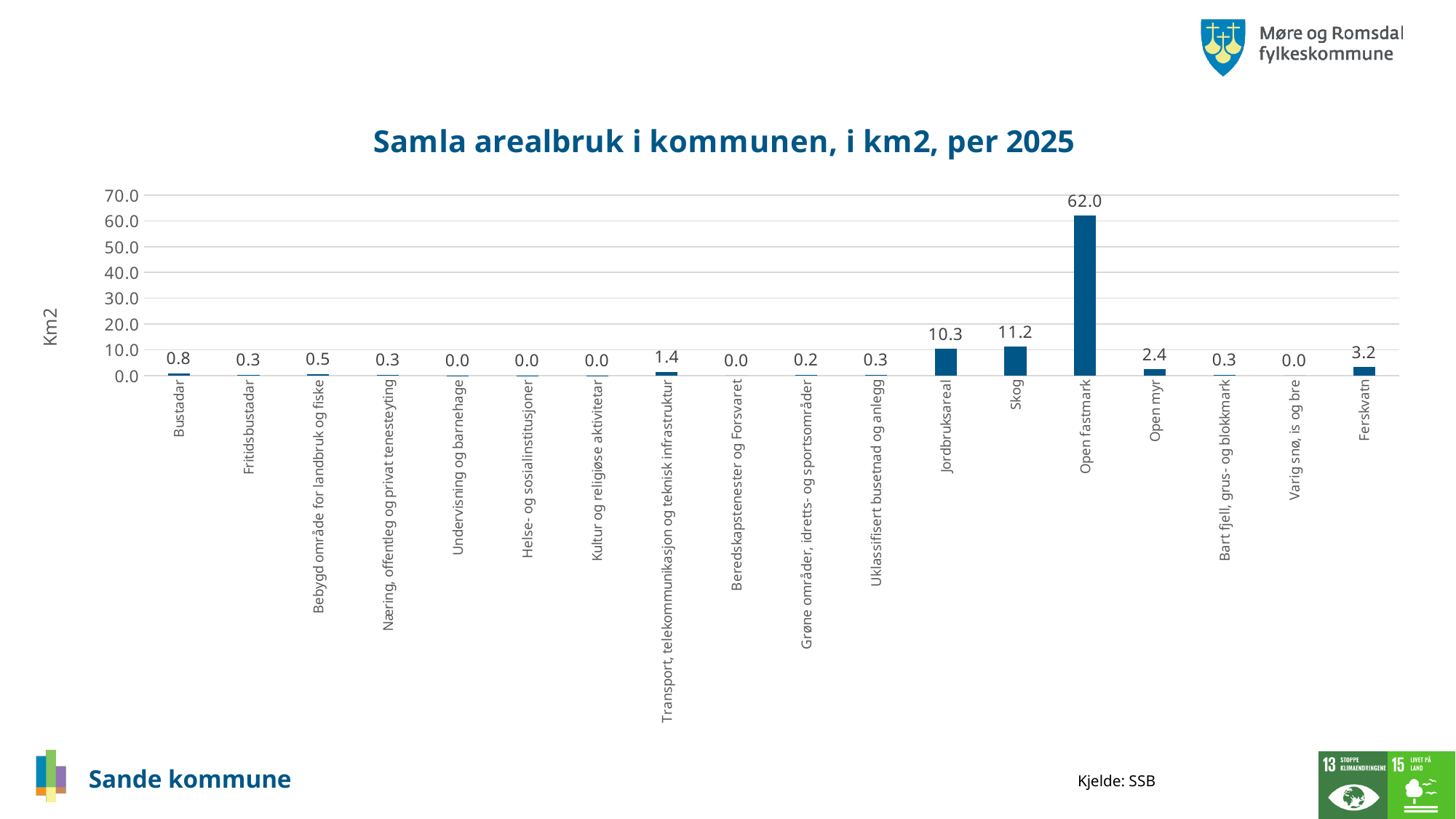
Is the value for Open fastmark greater or less than 60.0? greater What is the value for Ferskvatn? 3.2 Which category has the highest value? Open fastmark What is the difference between the values for Open fastmark and Skog? 50.8 How many categories are shown on the x axis? 18 What is the difference between the values for Skog and Jordbruksareal? 0.9 What is the value for Transport, telekommunikasjon og teknisk infrastruktur? 1.4 What is the value for Open fastmark? 62.0 Which is larger, the value for Ferskvatn or the value for Open myr? Ferskvatn What kind of chart is shown on the slide? Bar chart What is the value for Skog? 11.2 What is the value for Jordbruksareal? 10.3